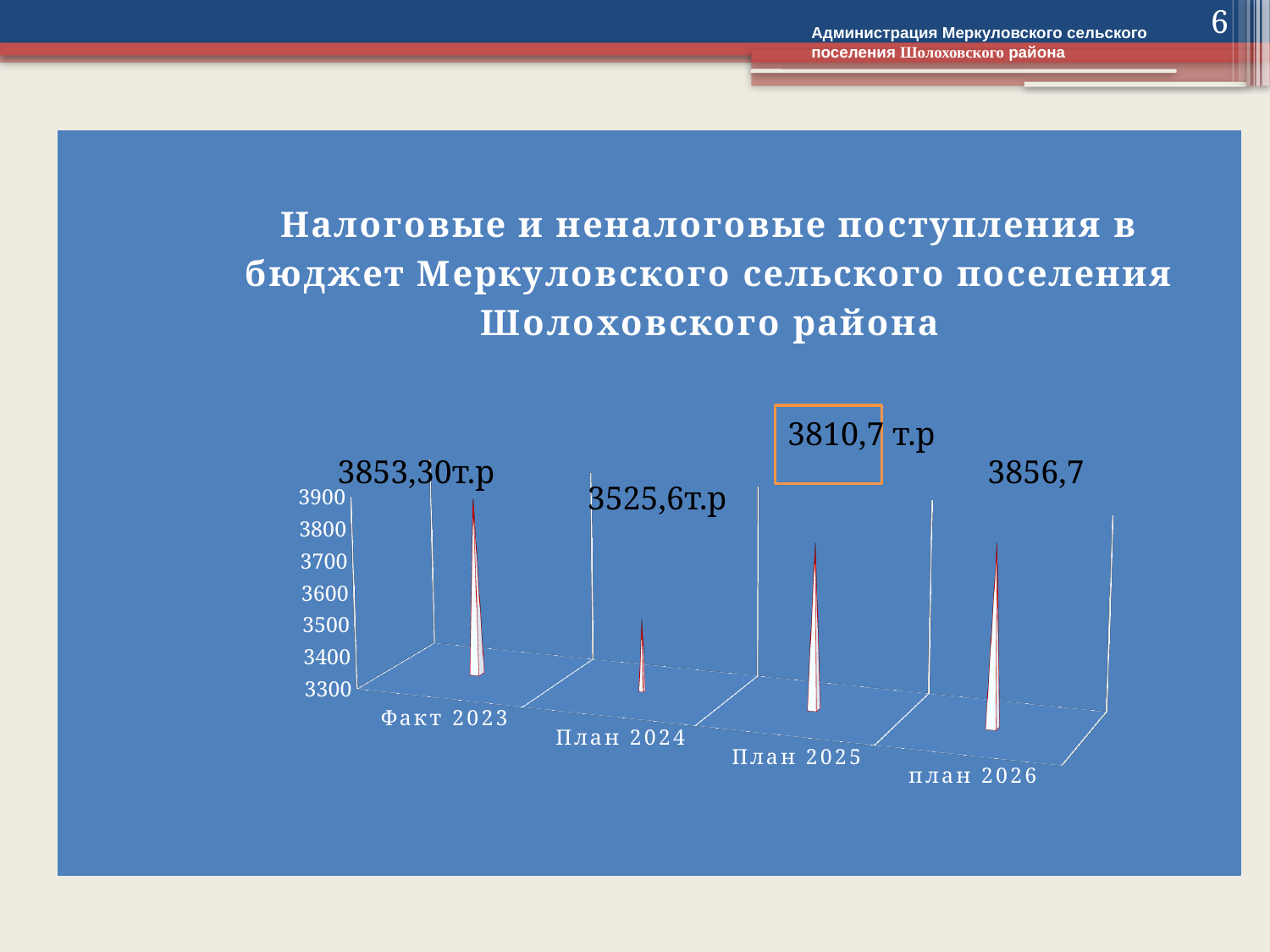
What is the difference between the values for план 2026 and План 2025? 46 What kind of chart is shown on the slide? bar chart Which category has the highest value according to the data labels? план 2026 Is the value for План 2024 greater or less than 3600? less What is the value shown for План 2024? 3525,6т.р What is the value shown for план 2026? 3856,7 How many categories are shown on the x axis? 4 What is the value shown for Факт 2023? 3853,30т.р What is the value shown for План 2025? 3810,7 т.р Which category has the lowest value? План 2024 What is the difference between the values for Факт 2023 and План 2024? 327,7 Which is larger, the value for Факт 2023 or the value for План 2024? Факт 2023